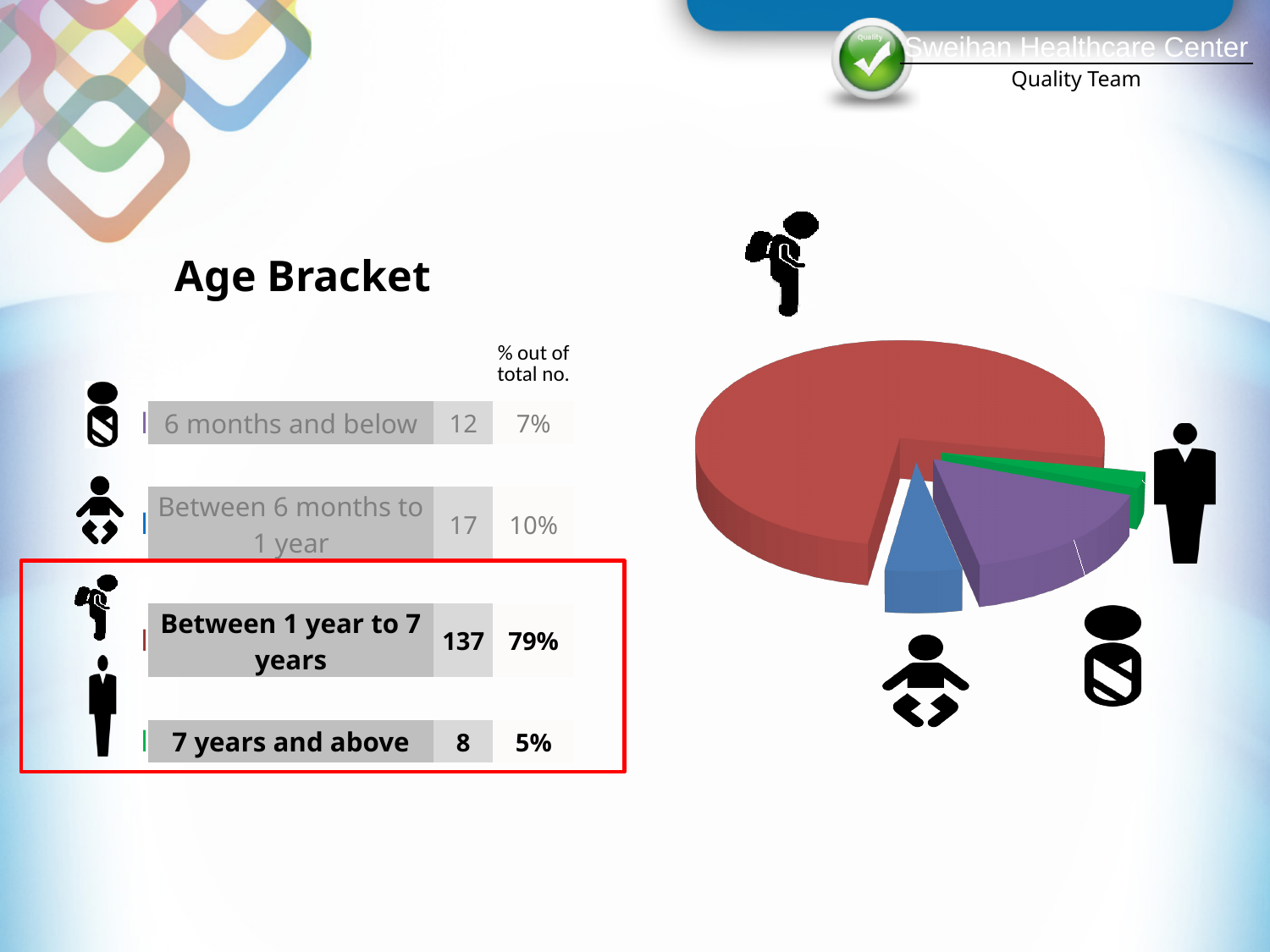
What percentage of the total does the 'Between 1 year to 7 years' bracket represent? 79% What is the difference in count between 'Between 6 months to 1 year' and '6 months and below'? 5 What is the count for the '7 years and above' age bracket? 8 What is the count for the '6 months and below' age bracket? 12 Which age bracket has the highest count? Between 1 year to 7 years What percentage of the total does the '7 years and above' bracket represent? 5% What is the count for the 'Between 1 year to 7 years' age bracket? 137 What is the count for the 'Between 6 months to 1 year' age bracket? 17 Which has a larger count: '6 months and below' or '7 years and above'? 6 months and below What kind of chart is shown on the slide? pie chart How many age bracket categories are listed on the slide? 4 Which age bracket has the lowest count? 7 years and above